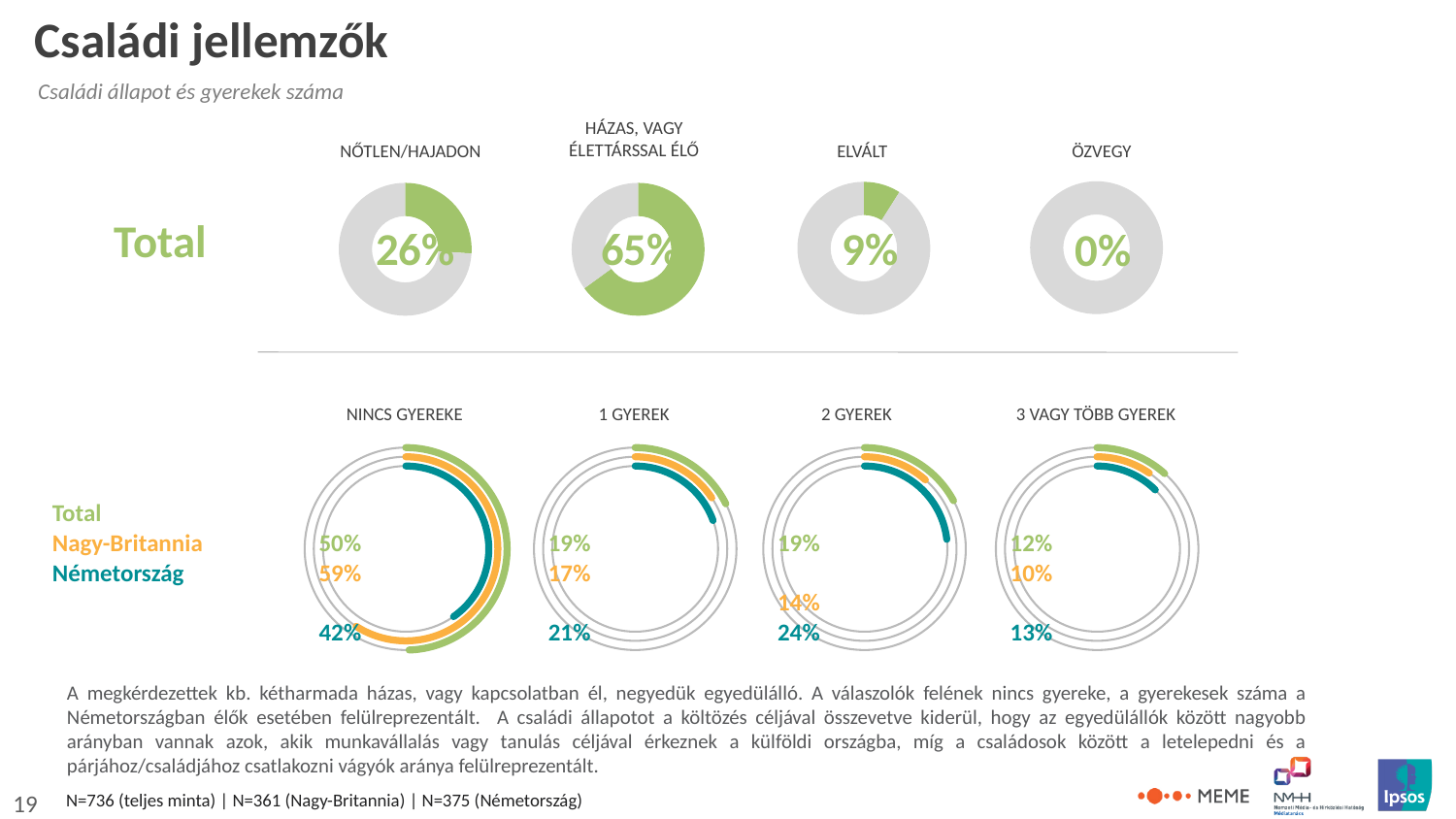
In the bottom row of charts (number of children), which is larger for 'Nincs gyereke': the Nagy-Britannia value or the Németország value? Nagy-Britannia How many series does the legend list for the bottom row of charts (number of children)? 3 In the bottom row of charts (number of children), what is the Total value for '3 vagy több gyerek'? 12% How many donut charts are in the top row (family status)? 4 In the top row of donut charts (family status, Total), what is the difference between the 'Házas, vagy élettárssal élő' and 'Nőtlen/hajadon' percentages? 39% In the top row of donut charts (family status, Total), what percentage is shown for 'Nőtlen/hajadon'? 26% In the bottom row of charts (number of children), what is the Németország value for 'Nincs gyereke'? 42% In the top row of donut charts (family status, Total), which category has the highest percentage? Házas, vagy élettárssal élő In the top row of donut charts (family status, Total), which category has the lowest percentage? Özvegy In the top row of donut charts (family status, Total), what percentage is shown for 'Házas, vagy élettárssal élő'? 65% In the bottom row of charts (number of children), what is the Nagy-Britannia value for '2 gyerek'? 14% In the bottom row of charts (number of children), what is the difference between the Németország and Nagy-Britannia values for '2 gyerek'? 10%